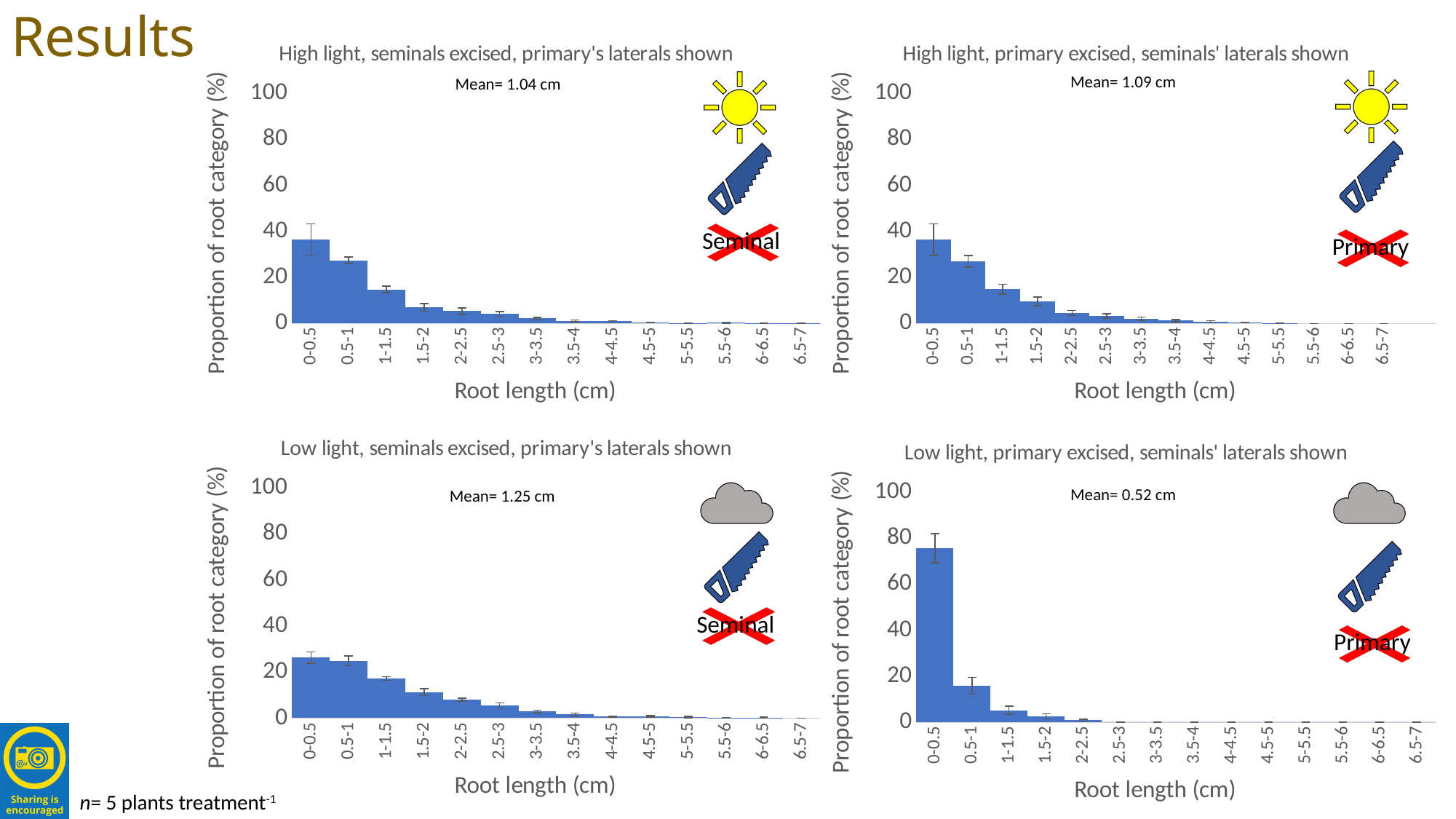
In the bottom-right chart titled 'Low light, primary excised, seminals' laterals shown', which root length category has the highest proportion? 0-0.5 In the top-left chart titled 'High light, seminals excised, primary's laterals shown', which root length category has the highest proportion? 0-0.5 What mean root length is annotated on the bottom-right chart titled 'Low light, primary excised, seminals' laterals shown'? Mean= 0.52 cm In the top-left chart titled 'High light, seminals excised, primary's laterals shown', is the value for the 0-0.5 category greater or less than 40? less In the bottom-right chart titled 'Low light, primary excised, seminals' laterals shown', is the value for the 0-0.5 category greater or less than 60? greater In the bottom-right chart titled 'Low light, primary excised, seminals' laterals shown', how many root length categories are shown on the x axis? 14 In the top-left chart titled 'High light, seminals excised, primary's laterals shown', do the values rise or fall as root length increases along the x axis? fall In the top-right chart titled 'High light, primary excised, seminals' laterals shown', is the value for the 0.5-1 category greater or less than 20? greater What kind of chart is the top-left chart titled 'High light, seminals excised, primary's laterals shown'? bar chart What mean root length is annotated on the bottom-left chart titled 'Low light, seminals excised, primary's laterals shown'? Mean= 1.25 cm In the bottom-right chart titled 'Low light, primary excised, seminals' laterals shown', which category has the larger value, 0-0.5 or 0.5-1? 0-0.5